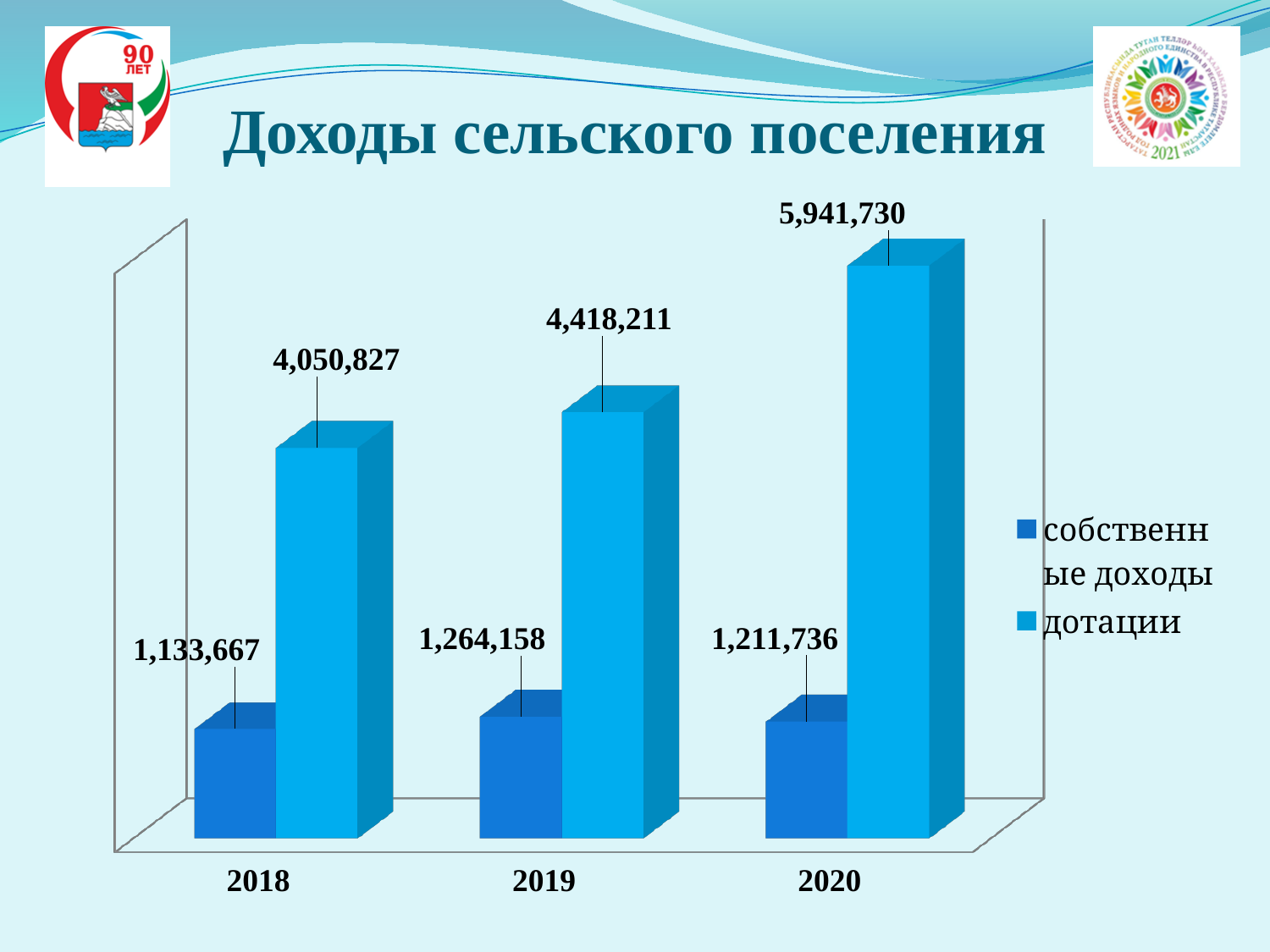
How many years are shown on the x axis? 3 How many series does the legend list? 2 In which year is дотации highest? 2020 What kind of chart is shown on the slide? Bar chart What is the difference between дотации in 2020 and in 2019? 1,523,519 Which is larger in 2019: собственные доходы or дотации? дотации What is the value of собственные доходы for 2020? 1,211,736 In which year is собственные доходы lowest? 2018 What is the difference between собственные доходы in 2019 and in 2018? 130,491 What is the value of дотации for 2019? 4,418,211 What is the value of дотации for 2020? 5,941,730 What is the value of собственные доходы for 2018? 1,133,667